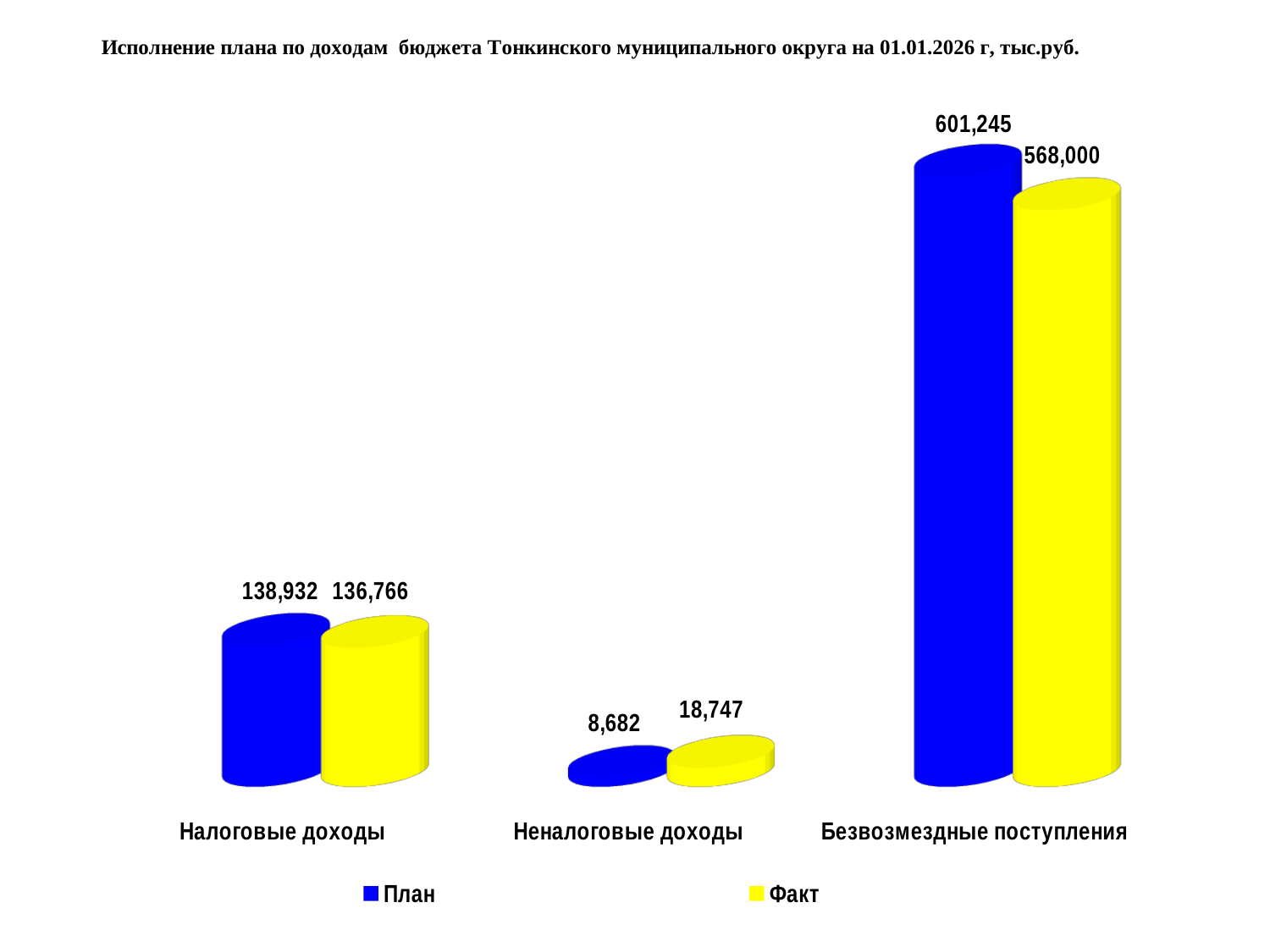
What is the План value for Налоговые доходы? 138,932 What is the difference between the Факт and План values for Неналоговые доходы? 10,065 Which category has the lowest Факт value? Неналоговые доходы For Неналоговые доходы, which is larger: План or Факт? Факт What is the difference between the План and Факт values for Безвозмездные поступления? 33,245 What is the Факт value for Безвозмездные поступления? 568,000 How many categories are shown on the x axis? 3 Which category has the highest План value? Безвозмездные поступления How many series does the legend list? 2 What is the План value for Неналоговые доходы? 8,682 What is the Факт value for Неналоговые доходы? 18,747 What kind of chart is shown on the slide? Bar chart